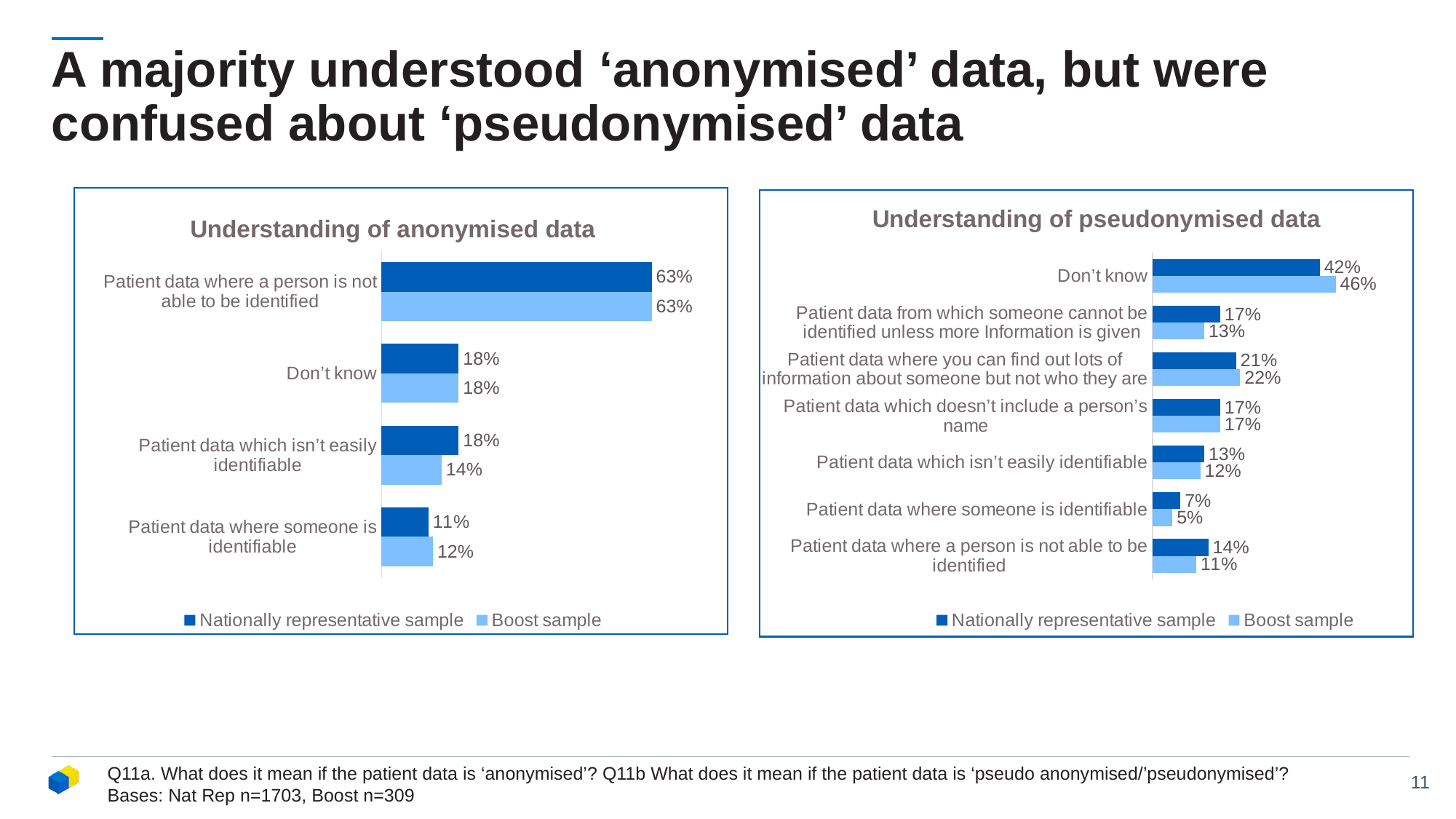
What type of chart is the 'Understanding of anonymised data' chart? Bar chart What is the title of the chart on the right side of the slide? Understanding of pseudonymised data In the 'Understanding of pseudonymised data' chart, which category has the highest Nationally representative sample value? Don't know How many series does the legend of the 'Understanding of anonymised data' chart list? 2 In the 'Understanding of pseudonymised data' chart, which is larger for 'Patient data from which someone cannot be identified unless more Information is given': the Nationally representative sample or the Boost sample? Nationally representative sample How many categories are shown in the 'Understanding of pseudonymised data' chart? 7 In the 'Understanding of pseudonymised data' chart, what is the Boost sample value for 'Don't know'? 46% In the 'Understanding of anonymised data' chart, what is the Boost sample value for 'Patient data which isn't easily identifiable'? 14% In the 'Understanding of pseudonymised data' chart, what is the Nationally representative sample value for 'Patient data where someone is identifiable'? 7% In the 'Understanding of pseudonymised data' chart, what is the difference between the Boost sample and Nationally representative sample values for 'Don't know'? 4% In the 'Understanding of anonymised data' chart, what is the value for 'Patient data where a person is not able to be identified' in the Nationally representative sample? 63% In the 'Understanding of anonymised data' chart, which category has the lowest Boost sample value? Patient data where someone is identifiable